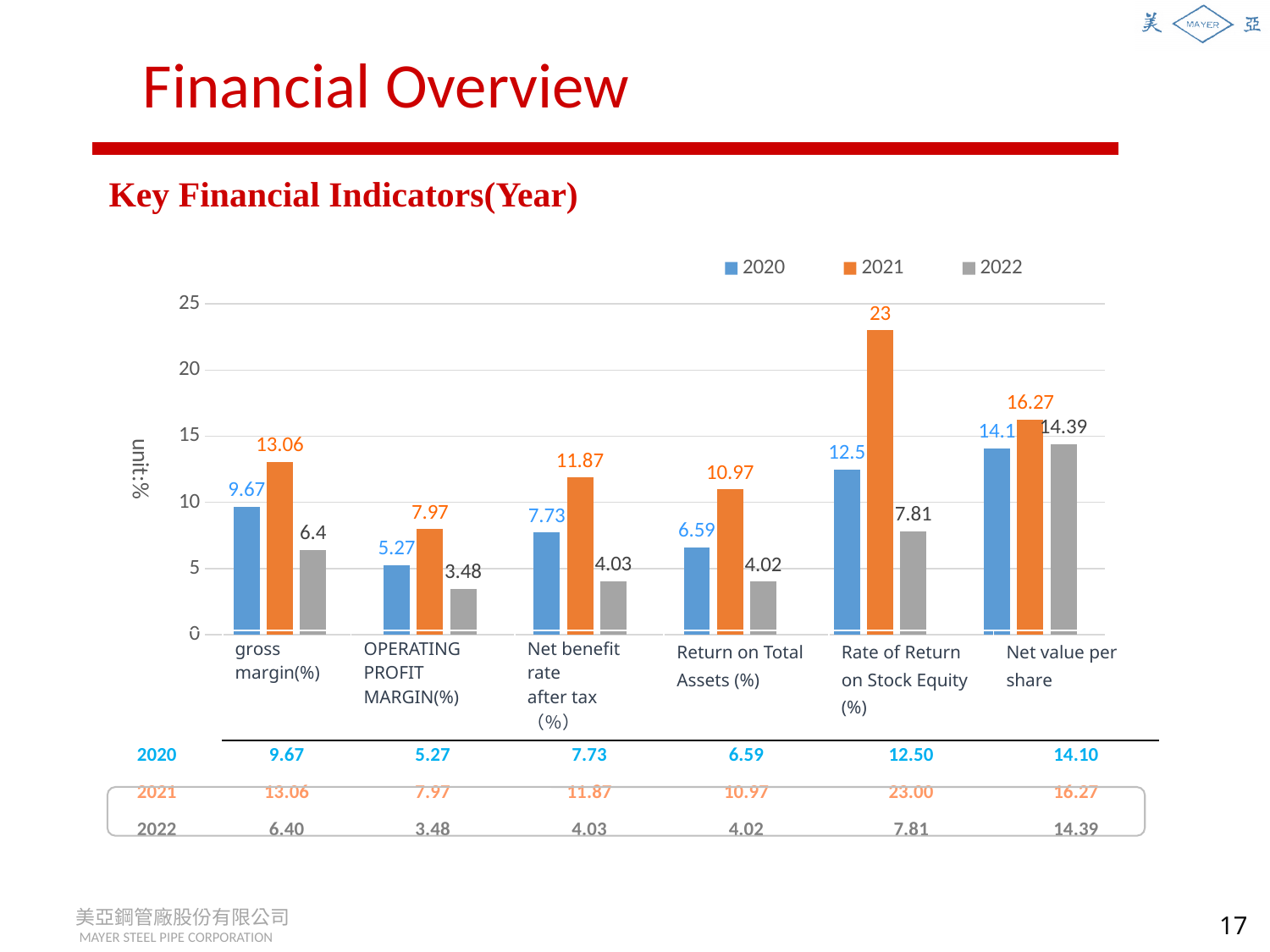
What is the 2021 value for Rate of Return on Stock Equity (%)? 23 Which category has the highest 2021 value? Rate of Return on Stock Equity (%) What is the 2022 value for gross margin(%)? 6.4 What unit is shown on the y axis label? unit:% How many categories are shown on the x axis? 6 What is the 2020 value for Net benefit rate after tax (%)? 7.73 Which category has the lowest 2022 value? OPERATING PROFIT MARGIN(%) What kind of chart is shown on the slide? Bar chart How many series does the legend list? 3 What is the difference between the 2021 and 2020 values for gross margin(%)? 3.39 Which is larger for Net value per share: the 2020 value or the 2022 value? 2022 What is the difference between the 2021 and 2022 values for Rate of Return on Stock Equity (%)? 15.19